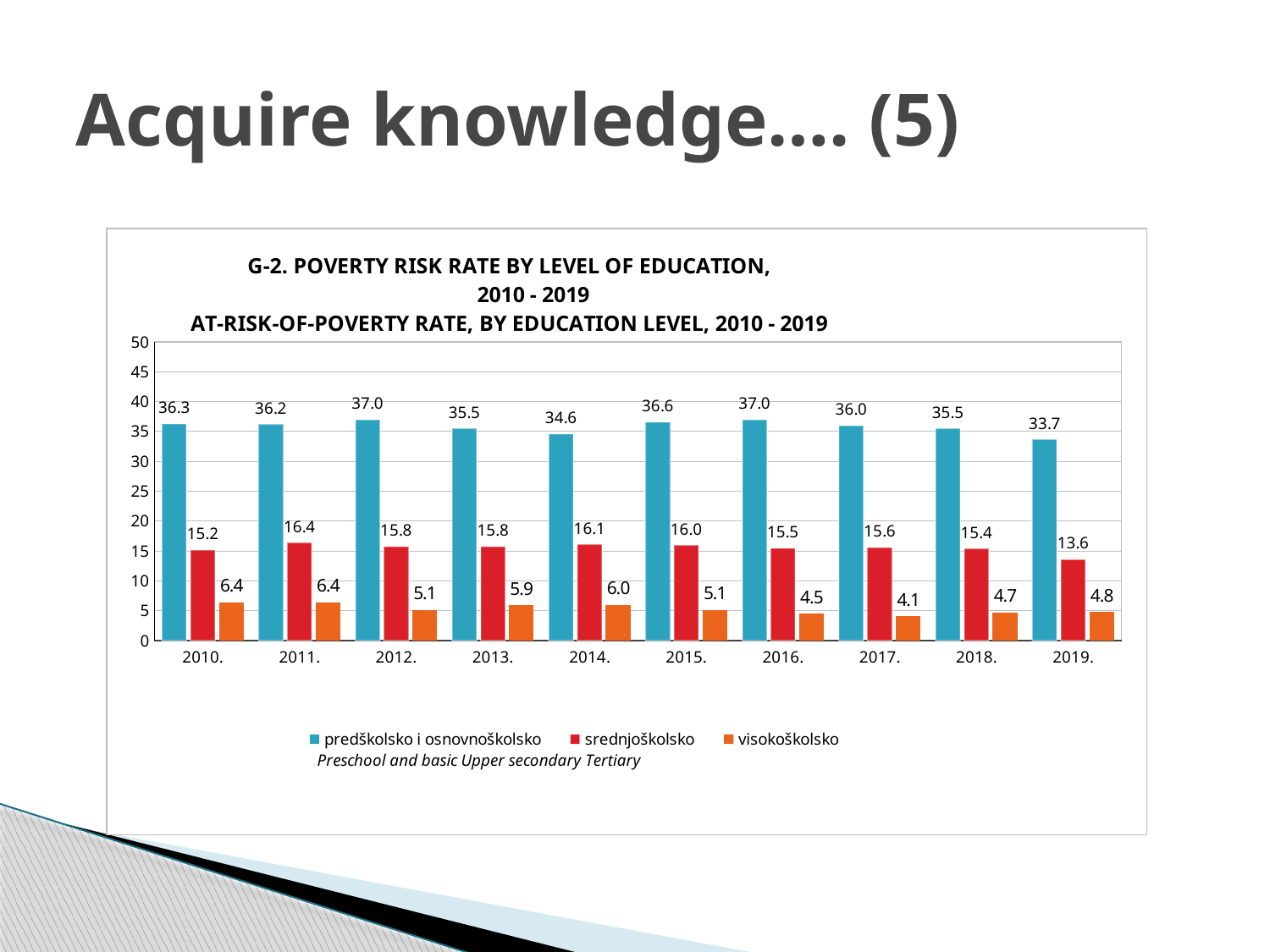
How many years are shown on the x axis? 10 In which year is the srednjoškolsko (Upper secondary) value highest? 2011. What is the difference between the predškolsko i osnovnoškolsko value in 2012. and in 2019.? 3.3 What is the value for predškolsko i osnovnoškolsko (Preschool and basic) in 2010.? 36.3 How many series does the legend list? 3 What is the value for visokoškolsko (Tertiary) in 2017.? 4.1 In which year is the visokoškolsko (Tertiary) value lowest? 2017. What is the value for srednjoškolsko (Upper secondary) in 2019.? 13.6 Is the value for predškolsko i osnovnoškolsko in 2014. greater or less than 30? greater What kind of chart is shown? bar chart Which is larger: the visokoškolsko value in 2013. or in 2016.? 2013. Which colour represents srednjoškolsko (Upper secondary) in the chart? red